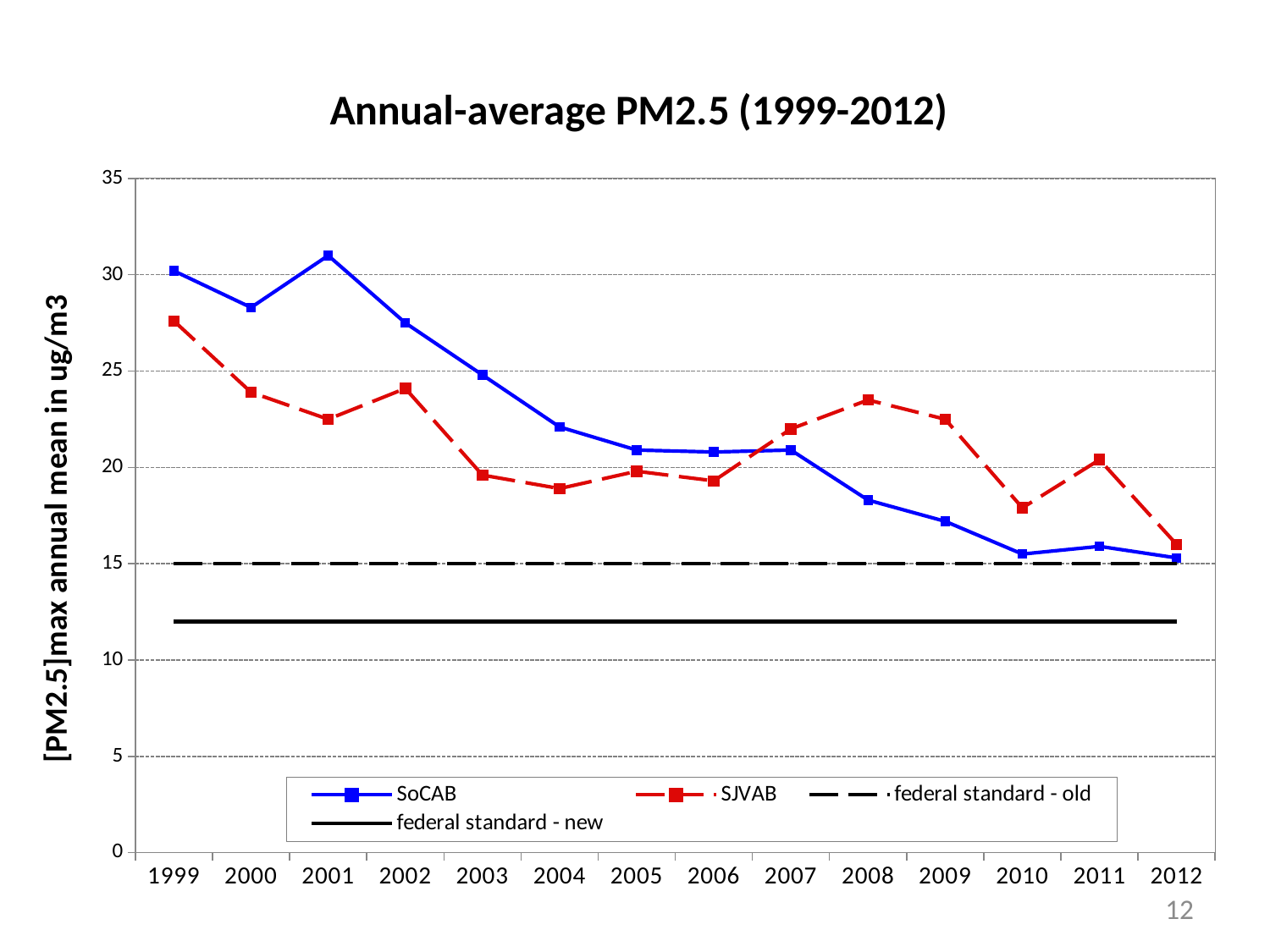
Which is larger in 2008, the SoCAB value or the SJVAB value? SJVAB In which year is the SJVAB value highest? 1999 What value does the 'federal standard - old' line sit at? 15 Does the SoCAB series generally rise or fall from 1999 to 2012? fall What kind of chart is shown on the slide? line chart In which year is the SoCAB value highest? 2001 How many years are shown on the x axis? 14 Is the SJVAB value for 2003 greater or less than 20? less In which year is the SJVAB value lowest? 2012 What is the title of the chart? Annual-average PM2.5 (1999-2012) How many series does the legend list? 4 Is the SoCAB value for 2001 greater or less than 30? greater